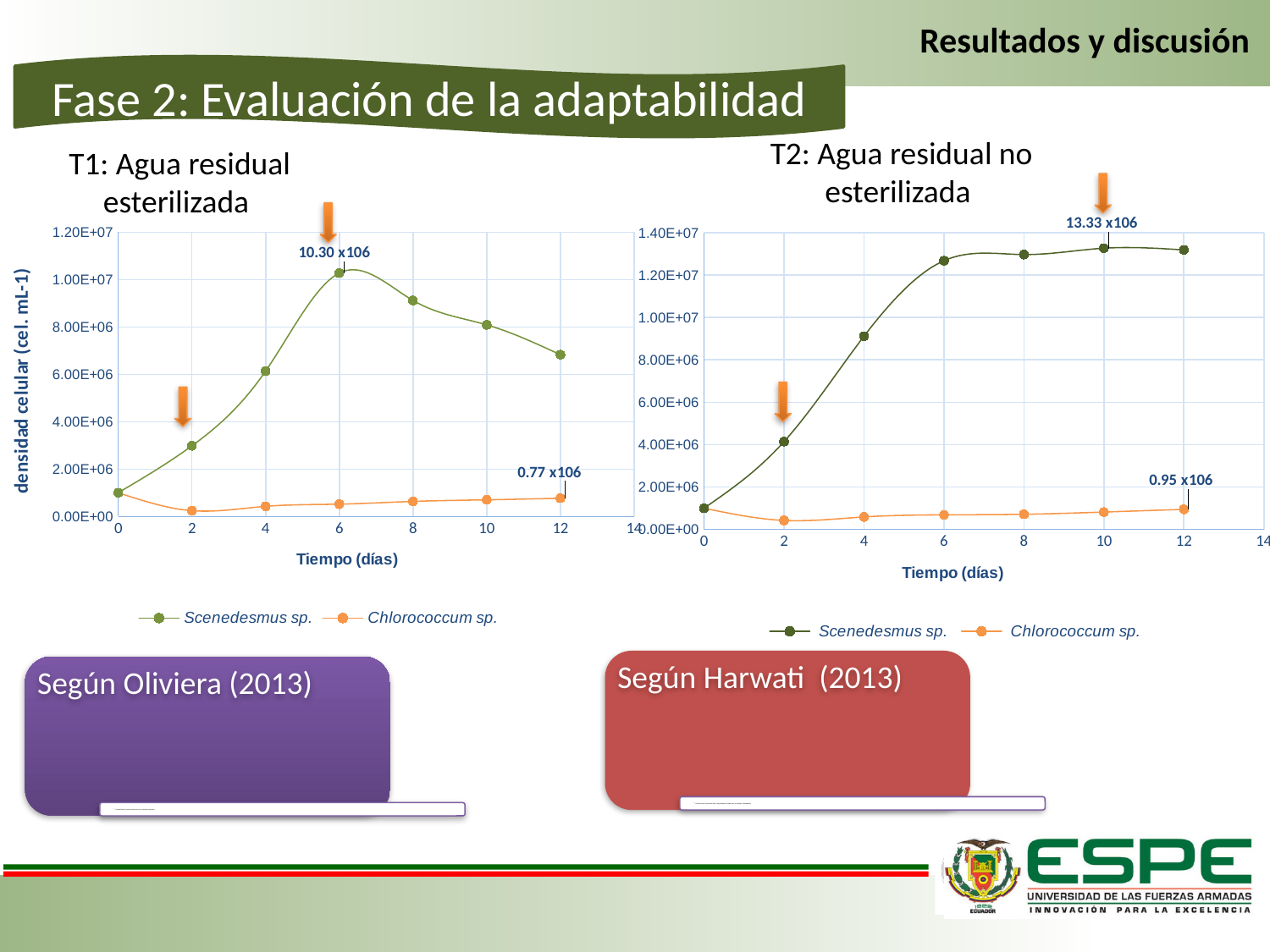
In the T2: Agua residual no esterilizada chart, how many series does the legend list? 2 In the T1: Agua residual esterilizada chart, what value is labelled for Scenedesmus sp. at day 6? 10.30 x106 In the T2: Agua residual no esterilizada chart, what value is labelled for Scenedesmus sp. at day 10? 13.33 x106 In the T1: Agua residual esterilizada chart, on which day does Scenedesmus sp. reach its highest value? 6 In the T1: Agua residual esterilizada chart, how many data points are plotted for each series? 7 In the T2: Agua residual no esterilizada chart, what value is labelled for Chlorococcum sp. at day 12? 0.95 x106 In the T1: Agua residual esterilizada chart, what value is labelled for Chlorococcum sp. at day 12? 0.77 x106 In the T1: Agua residual esterilizada chart, which series has the larger value at day 8, Scenedesmus sp. or Chlorococcum sp.? Scenedesmus sp. In the T2: Agua residual no esterilizada chart, what is the title of the x axis? Tiempo (días) In the T1: Agua residual esterilizada chart, does the Scenedesmus sp. line rise or fall between day 6 and day 12? fall In the T1: Agua residual esterilizada chart, what kind of chart is shown? line chart